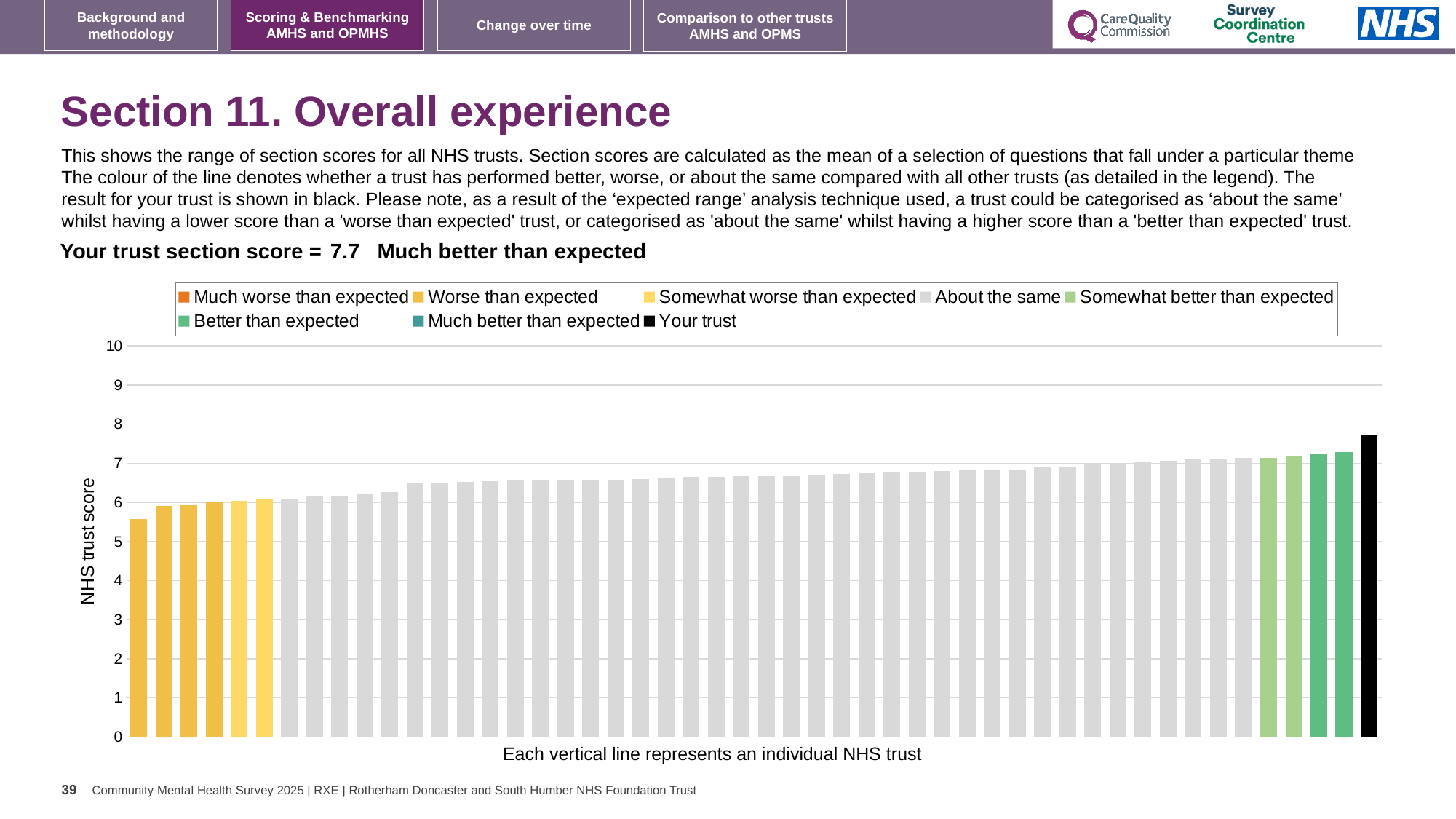
What is the label on the y axis of the chart? NHS trust score Do the bar values rise or fall from left to right along the x axis? rise Is the value of the lowest bar (the leftmost bar) greater or less than 6? less What is your trust's section score for Section 11, Overall experience? 7.7 According to the legend, what colour represents 'Your trust'? black Is the value of the black 'Your trust' bar greater or less than 7? greater What category is your trust's section score placed in? Much better than expected How many entries does the chart legend list? 8 Is the value of the highest bar greater or less than 8? less What kind of chart is shown on the slide? bar chart Which is larger: the leftmost bar or the black 'Your trust' bar? the black 'Your trust' bar Which bar in the chart is the highest? Your trust (the black bar)